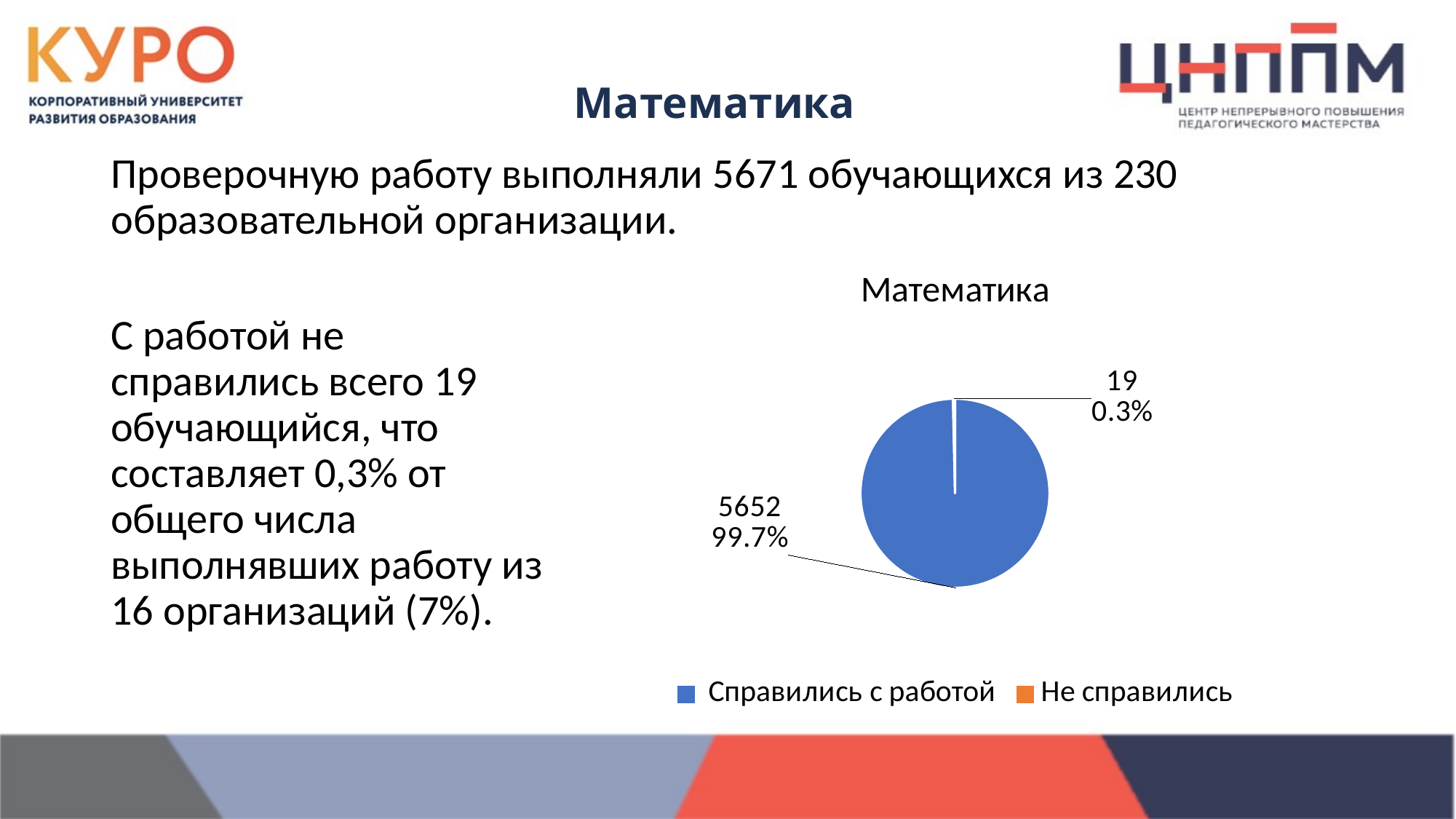
How many slices does the pie chart have? 2 Which colour represents "Не справились" in the legend? orange Which category has the largest slice? Справились с работой What kind of chart is shown on the slide? pie chart What is the value for "Справились с работой"? 5652 What share of the pie does "Справились с работой" represent? 99.7% How many series does the legend list? 2 What is the difference between the values for "Справились с работой" and "Не справились"? 5633 What is the value for "Не справились"? 19 What is the title of the chart? Математика What share of the pie does "Не справились" represent? 0.3% Which category has the smallest slice? Не справились